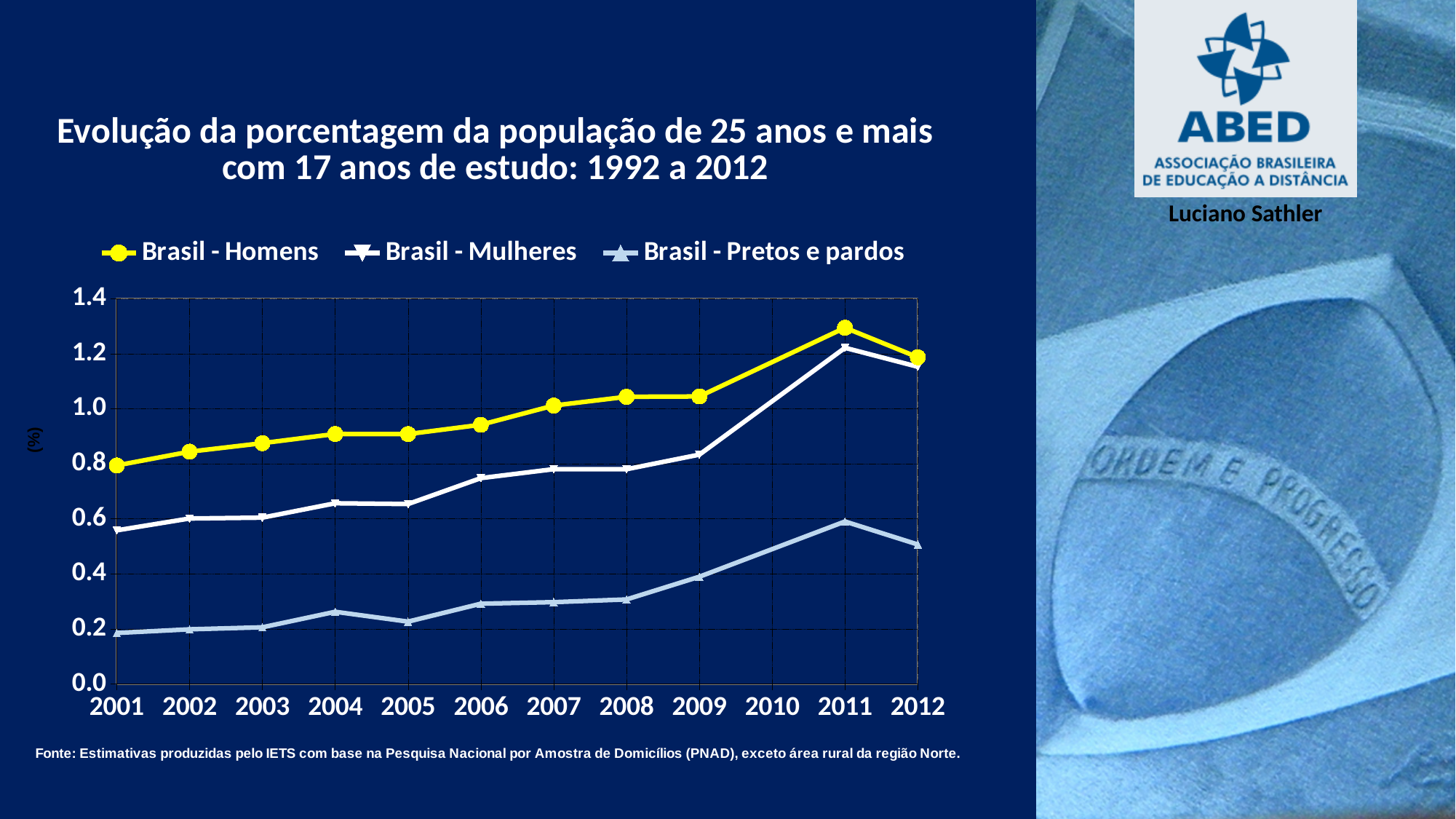
Does the Brasil - Homens series generally rise or fall from 2001 to 2011? rise How many years are shown on the x axis? 12 In 2005, which series has the larger value: Brasil - Homens or Brasil - Mulheres? Brasil - Homens Which series is drawn with a yellow line and circle markers? Brasil - Homens Is the value for Brasil - Pretos e pardos in 2001 greater or less than 0.4? less What kind of chart is shown on the slide? line chart In which year is the Brasil - Mulheres series at its lowest value? 2001 In which year does the Brasil - Pretos e pardos series reach its highest value? 2011 Is the value for Brasil - Homens in 2011 greater or less than 1.2? greater Is the value for Brasil - Mulheres in 2001 greater or less than 0.8? less In which year does the Brasil - Homens series reach its highest value? 2011 How many series does the legend list? 3